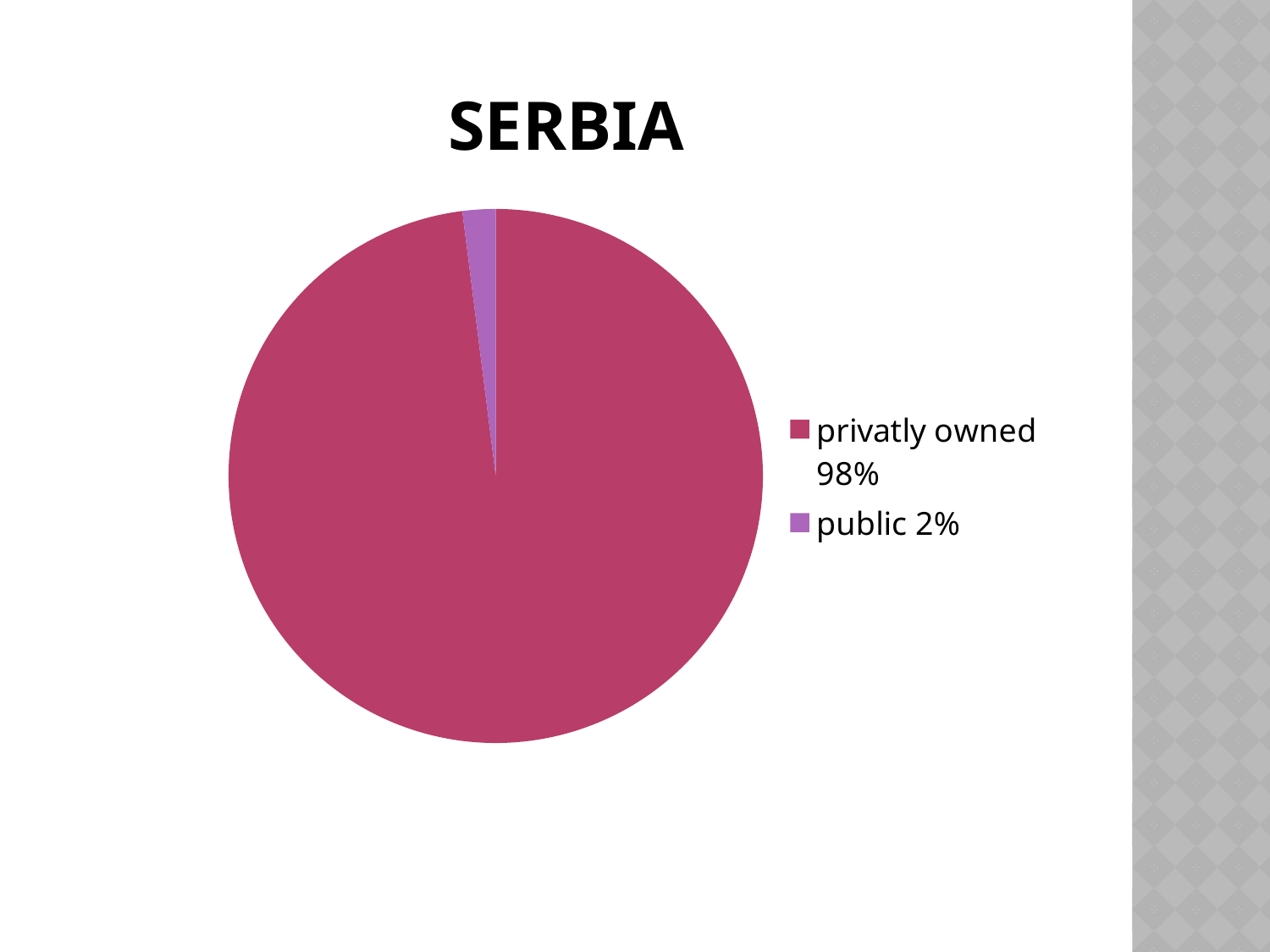
How many slices does the pie chart have? 2 What share of the pie is public? 2% What is the difference in percentage points between the privately owned share and the public share? 96 What is the title of the chart? SERBIA What share of the pie is privately owned? 98% Which category has the smallest slice of the pie? public What colour is the slice for public? purple What kind of chart is shown on the slide? pie chart How many entries does the legend list? 2 Which is larger, the privately owned share or the public share? privatly owned Which category has the largest slice of the pie? privatly owned